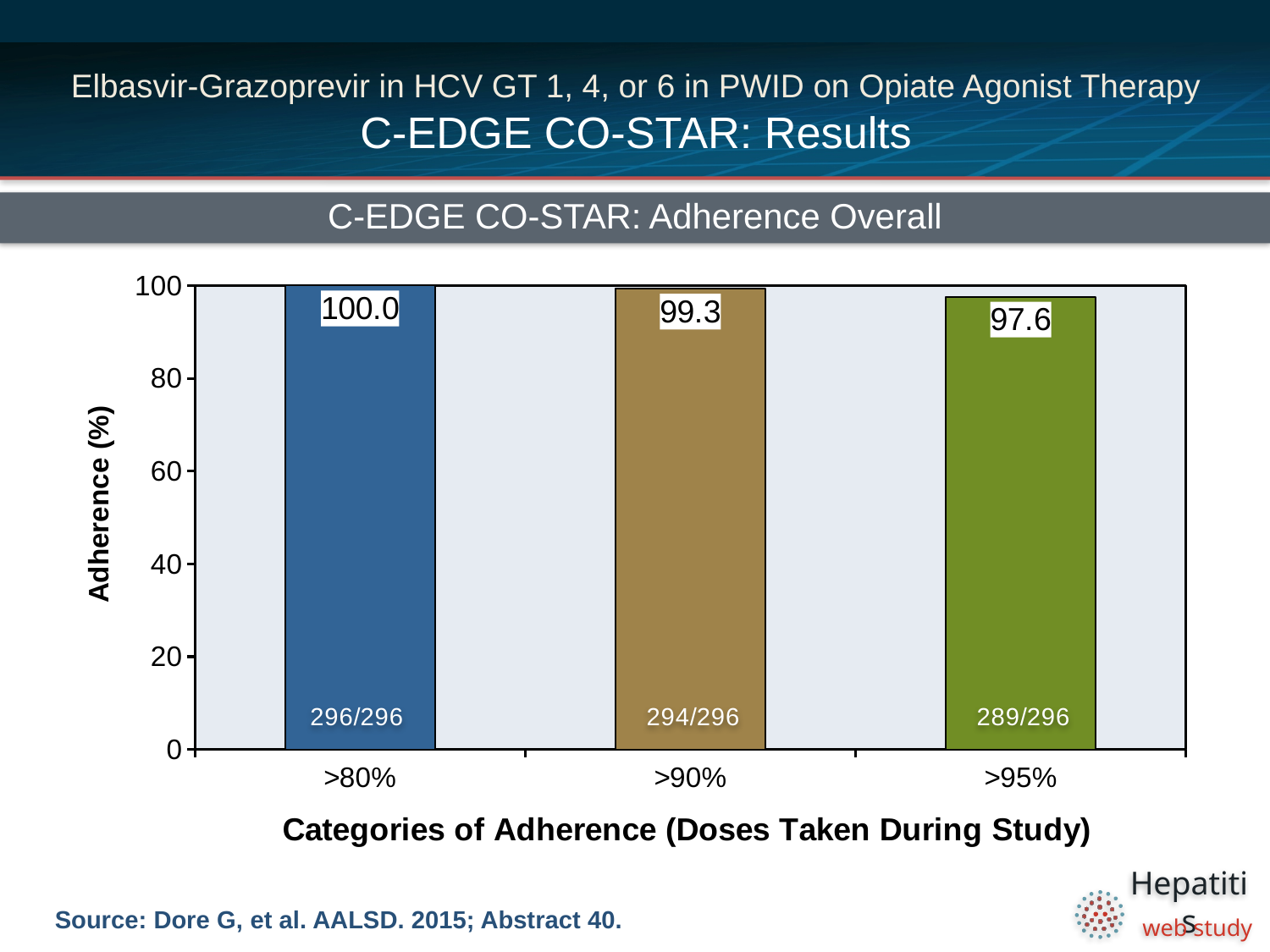
Which adherence category has the highest value? >80% What fraction of patients is shown inside the bar for the >90% category? 294/296 What fraction of patients is shown inside the bar for the >95% category? 289/296 What is the difference between the adherence values for the >80% and >95% categories? 2.4 What is the adherence value for the >95% category? 97.6 What is the adherence value for the >90% category? 99.3 Which adherence category has the lowest value? >95% What is the adherence value for the >80% category? 100.0 What kind of chart is shown on the slide? Bar chart Which has a larger adherence value, the >90% category or the >95% category? >90% How many adherence categories are shown on the x axis? 3 What is the label of the y axis? Adherence (%)